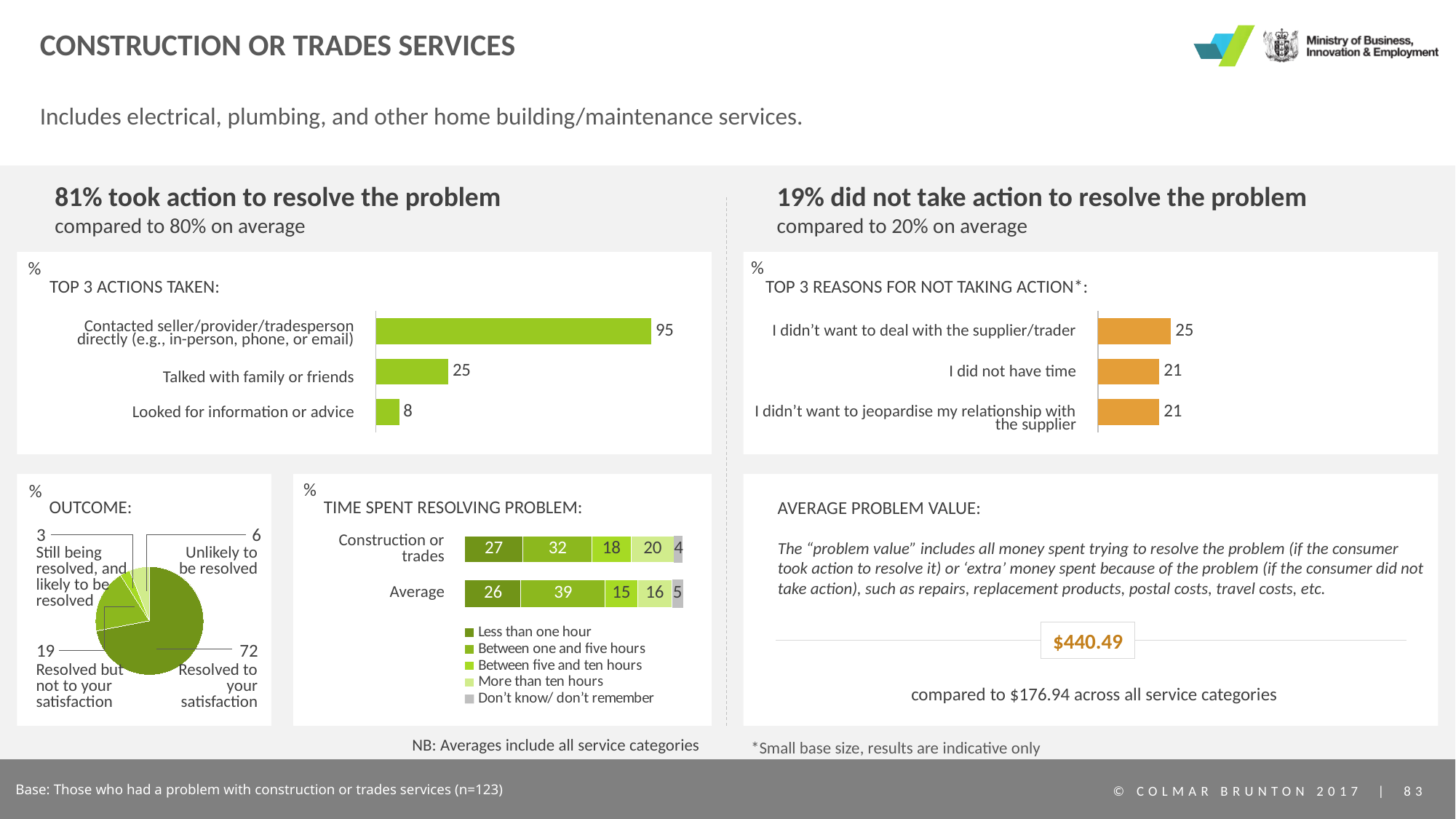
In the 'Top 3 reasons for not taking action' chart, what is the value for 'I didn't want to deal with the supplier/trader'? 25 In the 'Outcome' chart, what percentage was 'Resolved to your satisfaction'? 72 What kind of chart is the 'Top 3 reasons for not taking action' chart? bar chart In the 'Time spent resolving problem' chart, how many series does the legend list? 5 In the 'Time spent resolving problem' chart, what is the 'Between one and five hours' value for 'Construction or trades'? 32 In the 'Top 3 reasons for not taking action' chart, how many reasons are listed? 3 In the 'Top 3 actions taken' chart, what is the difference between 'Contacted seller/provider/tradesperson directly' and 'Looked for information or advice'? 87 In the 'Top 3 actions taken' chart, what is the value for 'Talked with family or friends'? 25 In the 'Top 3 actions taken' chart, which action has the highest value? Contacted seller/provider/tradesperson directly (e.g., in-person, phone, or email) In the 'Outcome' chart, which outcome has the smallest share? Still being resolved, and likely to be resolved What kind of chart is the 'Outcome' chart? pie chart In the 'Time spent resolving problem' chart, which is larger for 'Less than one hour': 'Construction or trades' or 'Average'? Construction or trades